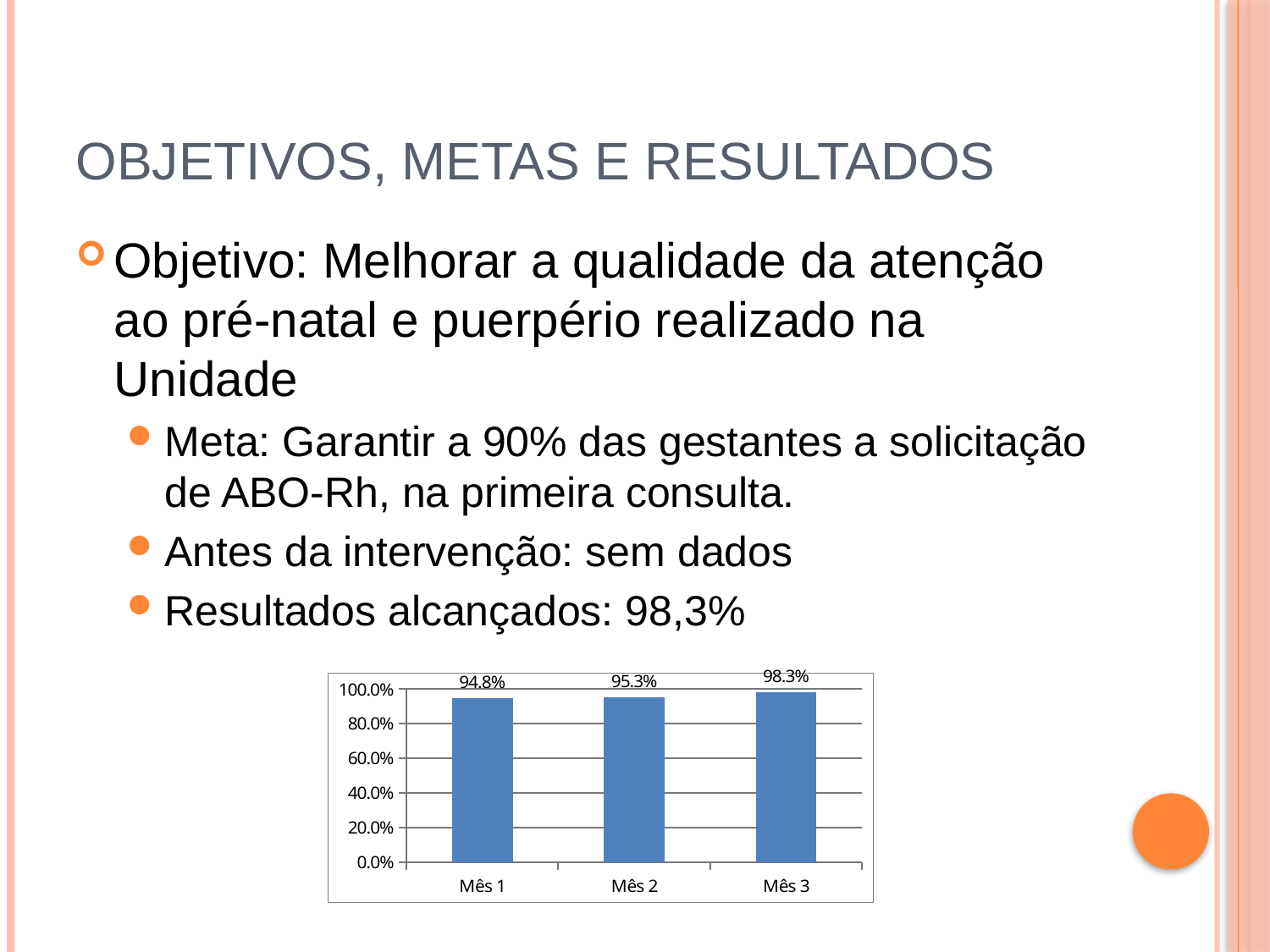
What kind of chart is shown on the slide? bar chart Which month has the lowest value? Mês 1 What is the value for Mês 3? 98.3% What is the value for Mês 1? 94.8% What is the value for Mês 2? 95.3% Which is larger, the value for Mês 3 or the value for Mês 2? Mês 3 Do the values rise or fall from Mês 1 to Mês 3? rise Is the value for Mês 1 greater or less than 80.0%? greater How many categories are shown on the x axis? 3 Which month has the highest value? Mês 3 What is the difference between the values for Mês 2 and Mês 1? 0.5% What is the difference between the values for Mês 3 and Mês 1? 3.5%